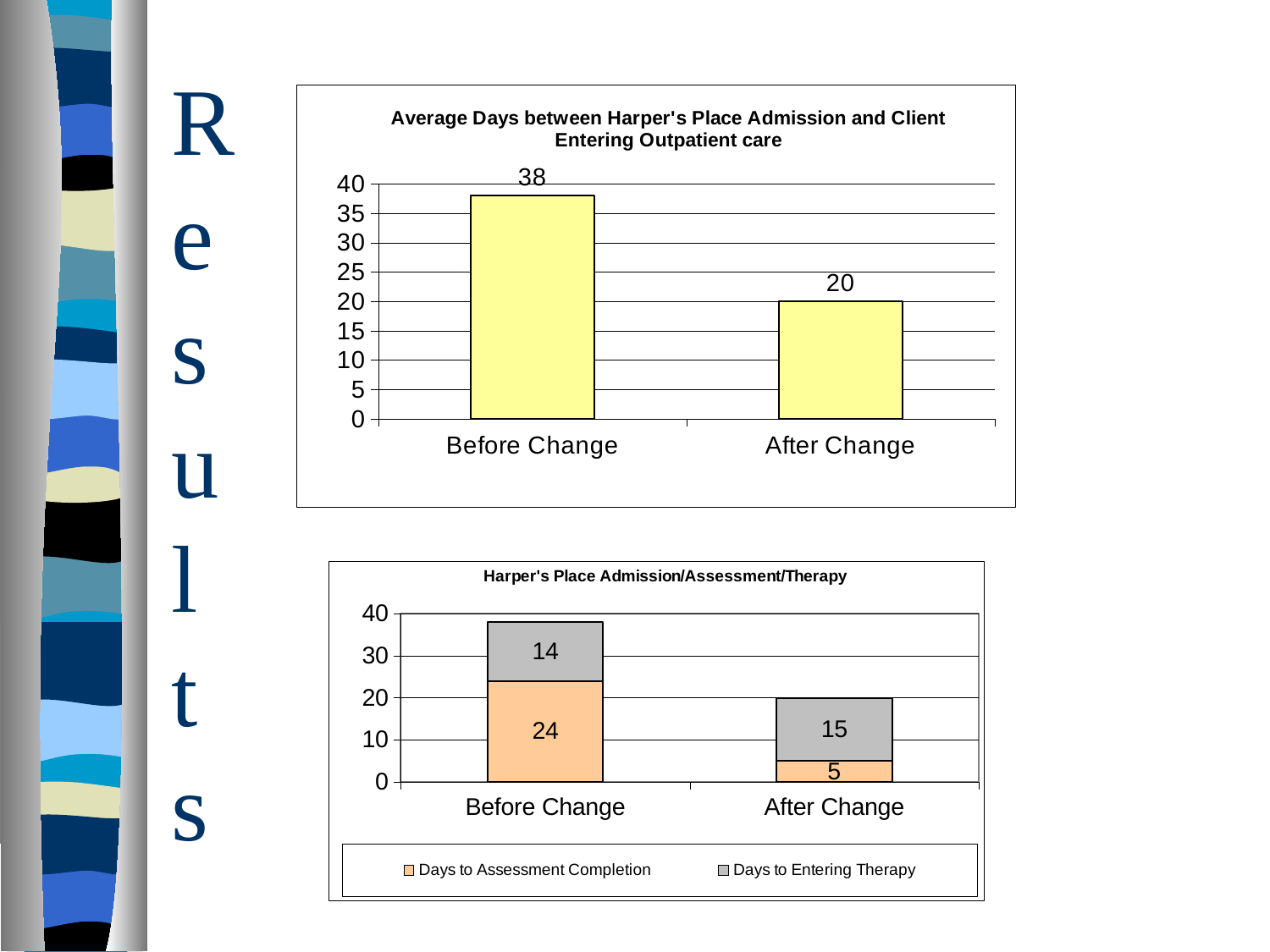
In the bottom chart 'Harper's Place Admission/Assessment/Therapy', what colour represents Days to Entering Therapy? Grey In the bottom chart 'Harper's Place Admission/Assessment/Therapy', what is the value of Days to Entering Therapy for After Change? 15 In the top chart 'Average Days between Harper's Place Admission and Client Entering Outpatient care', what is the difference between the Before Change and After Change values? 18 In the top chart 'Average Days between Harper's Place Admission and Client Entering Outpatient care', what kind of chart is shown? Bar chart In the bottom chart 'Harper's Place Admission/Assessment/Therapy', how many series does the legend list? 2 In the top chart 'Average Days between Harper's Place Admission and Client Entering Outpatient care', what is the value for After Change? 20 In the bottom chart 'Harper's Place Admission/Assessment/Therapy', which is larger: Days to Assessment Completion for Before Change or for After Change? Before Change In the top chart 'Average Days between Harper's Place Admission and Client Entering Outpatient care', which category has the higher value? Before Change In the bottom chart 'Harper's Place Admission/Assessment/Therapy', what is the total of the stacked bar for After Change? 20 In the bottom chart 'Harper's Place Admission/Assessment/Therapy', what is the value of Days to Assessment Completion for Before Change? 24 In the bottom chart 'Harper's Place Admission/Assessment/Therapy', what is the total of the stacked bar for Before Change? 38 In the top chart 'Average Days between Harper's Place Admission and Client Entering Outpatient care', what is the value for Before Change? 38